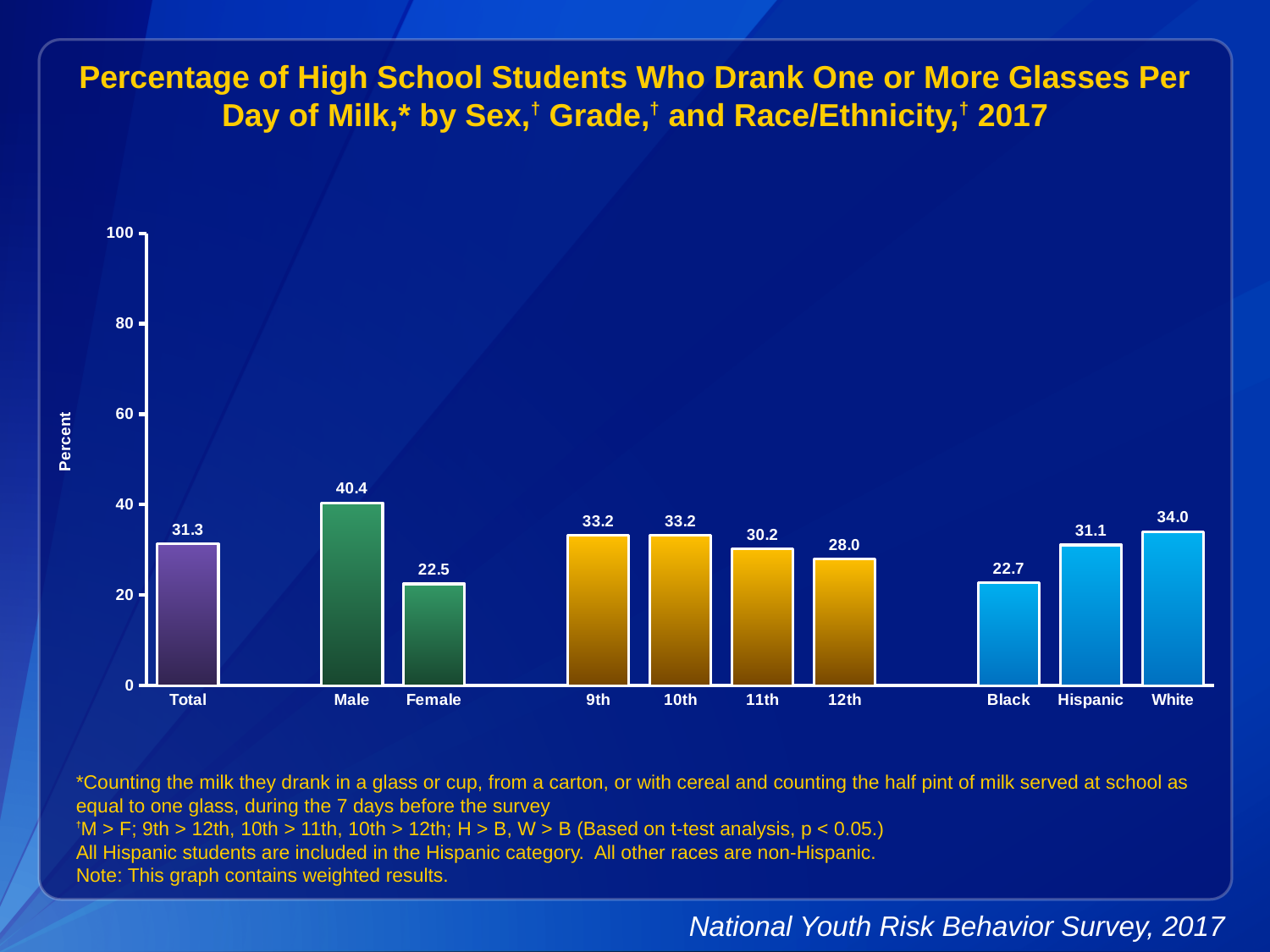
Which is larger, the value for 9th grade or the value for 12th grade? 9th Which category has the lowest value? Female Is the value for Male greater or less than 40? greater Which category has the highest value? Male What kind of chart is shown on the slide? bar chart What is the value for Hispanic? 31.1 What is the value for 11th grade? 30.2 What is the value for Female? 22.5 What is the value for Total? 31.3 How many bars are shown in the chart? 10 What is the difference between the Male and Female values? 17.9 What is the difference between the White and Black values? 11.3